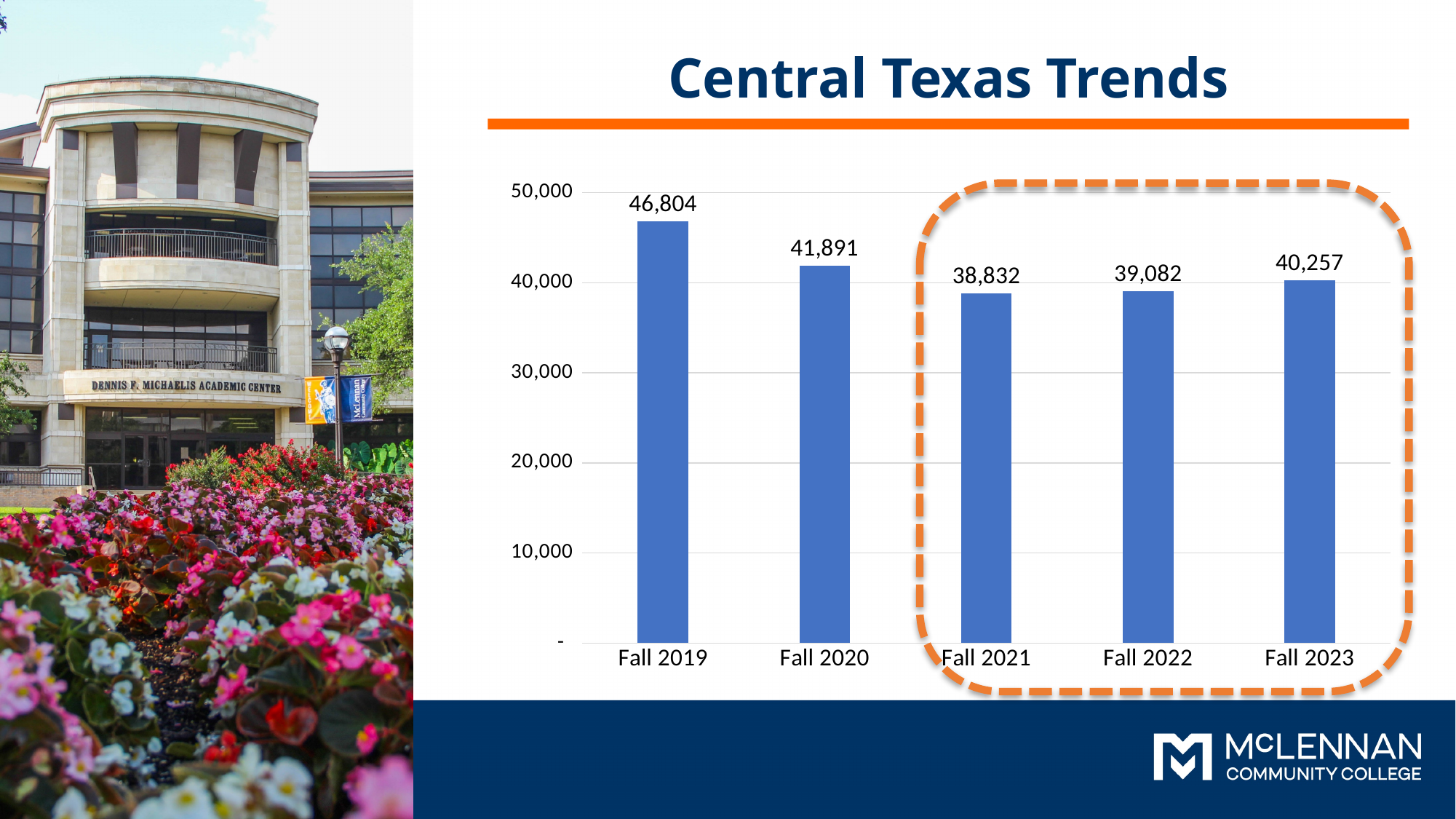
What is the difference between the Fall 2019 and Fall 2020 values? 4,913 How many categories are shown on the x axis? 5 What is the value for Fall 2023? 40,257 What kind of chart is shown on the slide? bar chart Which is larger, the value for Fall 2020 or the value for Fall 2023? Fall 2020 What is the difference between the Fall 2023 and Fall 2022 values? 1,175 Is the value for Fall 2022 greater or less than 40,000? less Which category has the highest value? Fall 2019 What is the title of the chart? Central Texas Trends What is the value for Fall 2019? 46,804 Which category has the lowest value? Fall 2021 What is the value for Fall 2021? 38,832